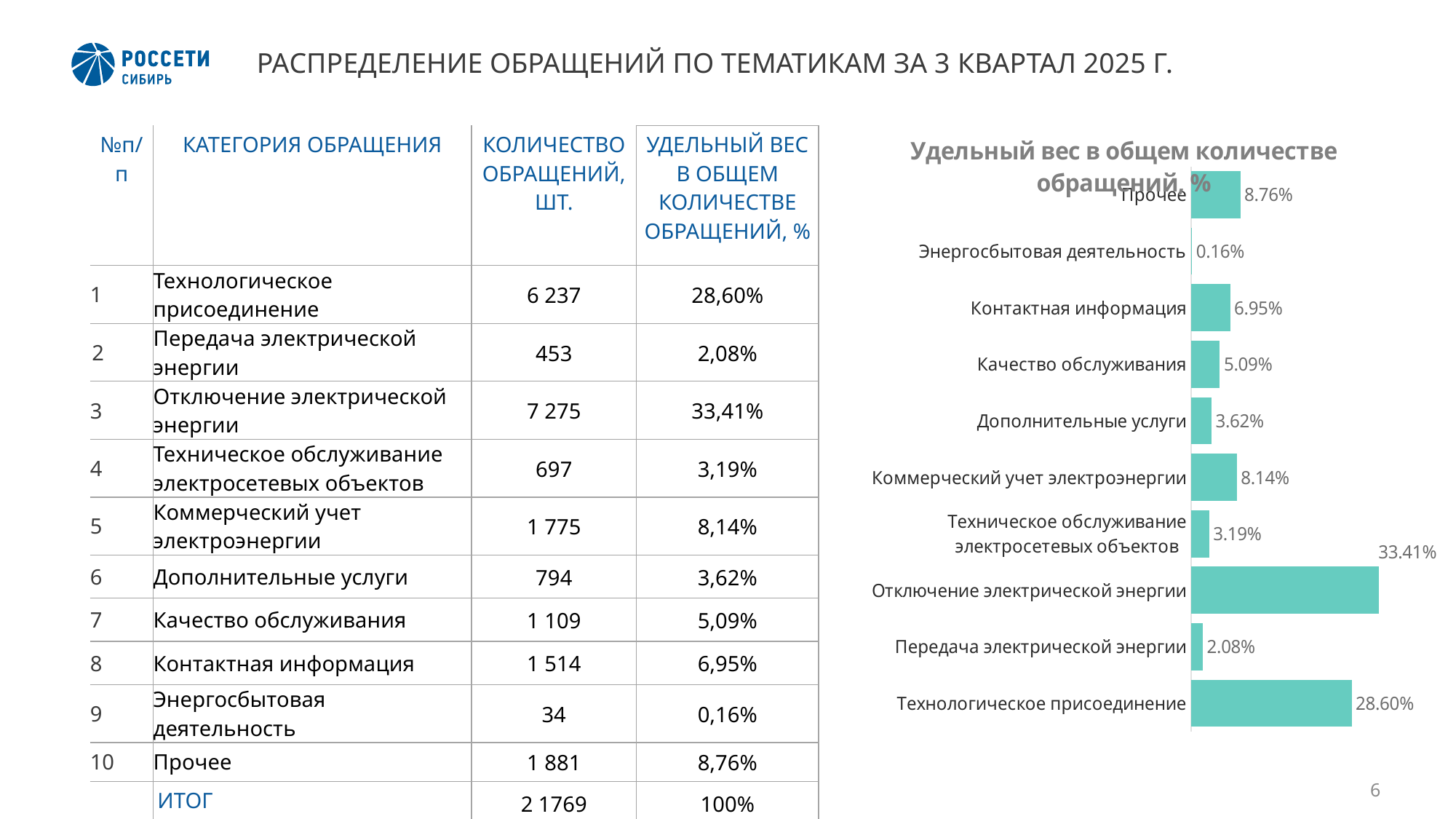
What is the value for Отключение электрической энергии in the chart? 33.41% What is the value for Технологическое присоединение in the chart? 28.60% What is the title of the chart? Удельный вес в общем количестве обращений, % Which category has the lowest value in the chart? Энергосбытовая деятельность Which category has the highest value in the chart? Отключение электрической энергии What is the difference between the values for Отключение электрической энергии and Технологическое присоединение? 4.81% What is the value for Энергосбытовая деятельность in the chart? 0.16% How many categories does the chart show? 10 What type of chart is shown on the slide? bar chart What is the difference between the values for Качество обслуживания and Дополнительные услуги? 1.47% What is the value for Коммерческий учет электроэнергии in the chart? 8.14% Which is larger: the value for Прочее or the value for Контактная информация? Прочее